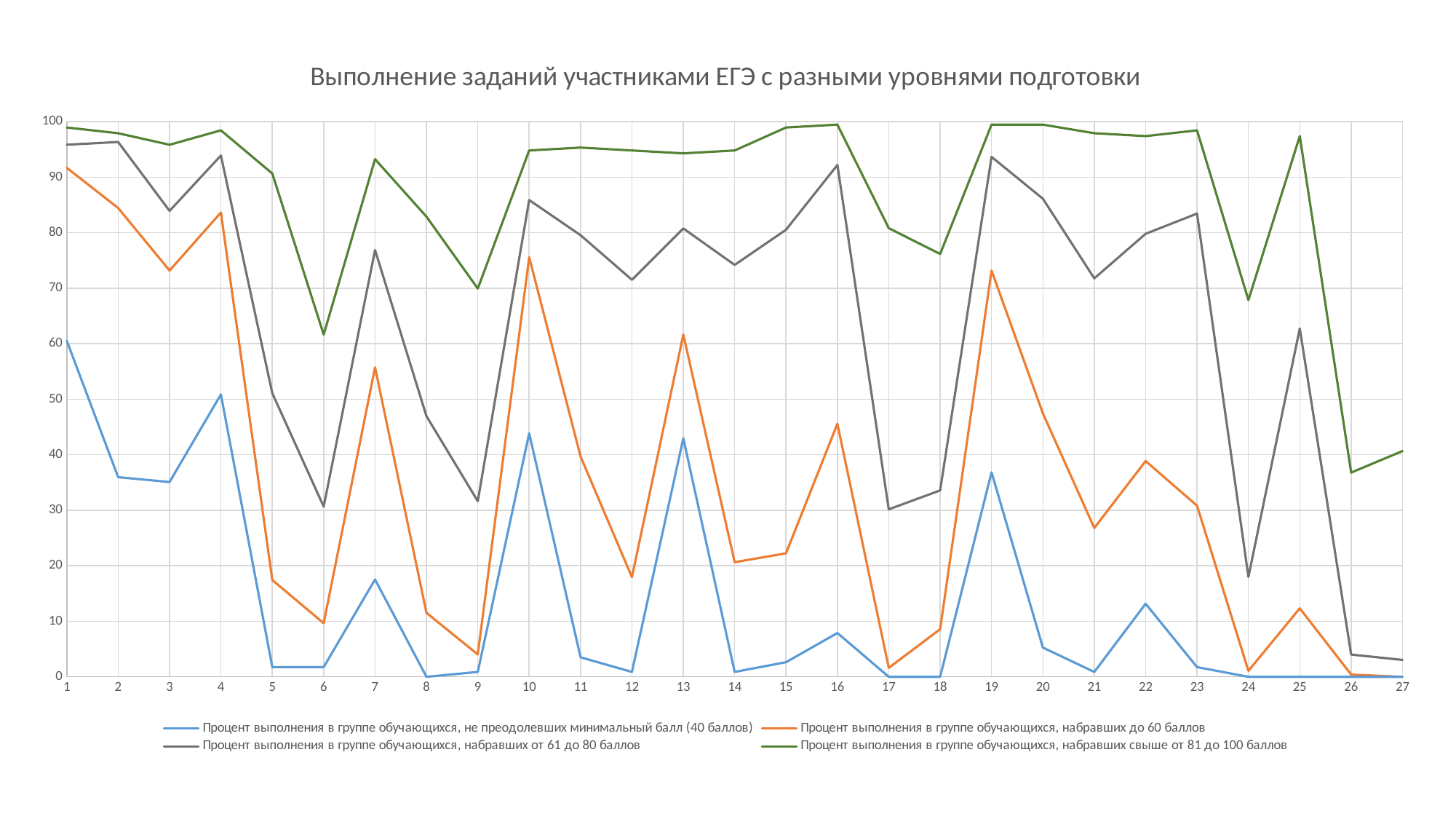
For the series 'не преодолевших минимальный балл (40 баллов)', which task has the highest value? 1 At task 25, which series has the larger value: 'набравших от 61 до 80 баллов' or 'набравших до 60 баллов'? набравших от 61 до 80 баллов Is the value for task 6 in the series 'набравших свыше от 81 до 100 баллов' greater or less than 70? less How many tasks (points) are shown along the x axis? 27 What is the title of the chart? Выполнение заданий участниками ЕГЭ с разными уровнями подготовки Is the value for task 1 in the series 'не преодолевших минимальный балл (40 баллов)' greater or less than 50? greater What kind of chart is shown on the slide? line chart Which colour is used for the series 'Процент выполнения в группе обучающихся, набравших свыше от 81 до 100 баллов'? green How many series does the legend list? 4 For the series 'набравших до 60 баллов', do the values rise or fall from task 1 to task 3? fall Is the value for task 17 in the series 'набравших от 61 до 80 баллов' greater or less than 40? less